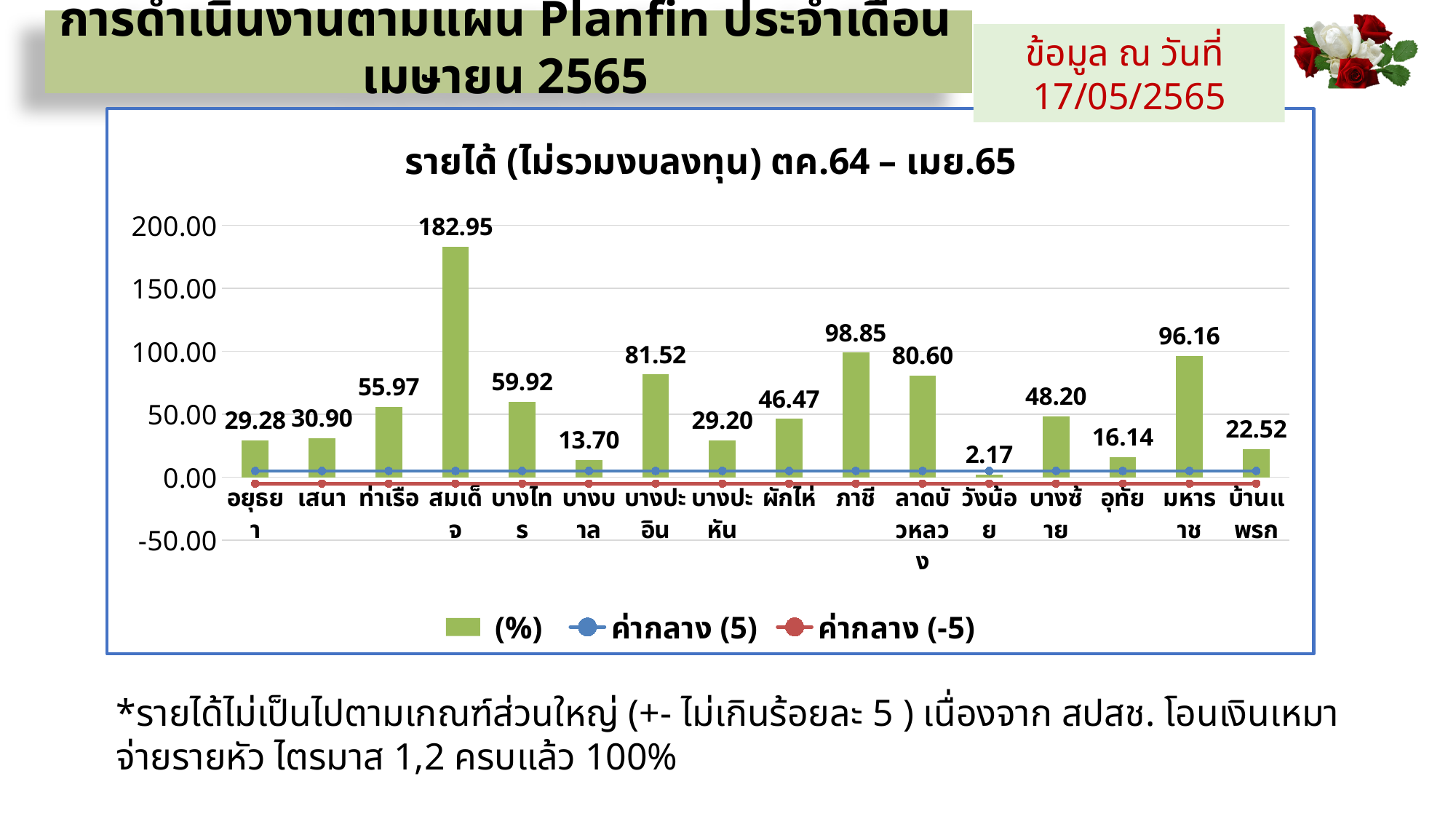
Which category has the lowest value in the chart? วังน้อย Which has a larger value, ลาดบัวหลวง or บางซ้าย? ลาดบัวหลวง How many categories are shown on the x axis of the chart? 16 What is the value for วังน้อย in the chart? 2.17 Is the value for ท่าเรือ greater or less than 50.00? greater What is the title of the chart? รายได้ (ไม่รวมงบลงทุน) ตค.64 – เมย.65 What is the value for ภาชี in the chart? 98.85 What is the value for สมเด็จ in the chart? 182.95 What is the difference between the values for มหาราช and บางปะอิน? 14.64 How many series does the legend list? 3 Which category has the highest value in the chart? สมเด็จ What kind of chart is used to show the (%) series? bar chart